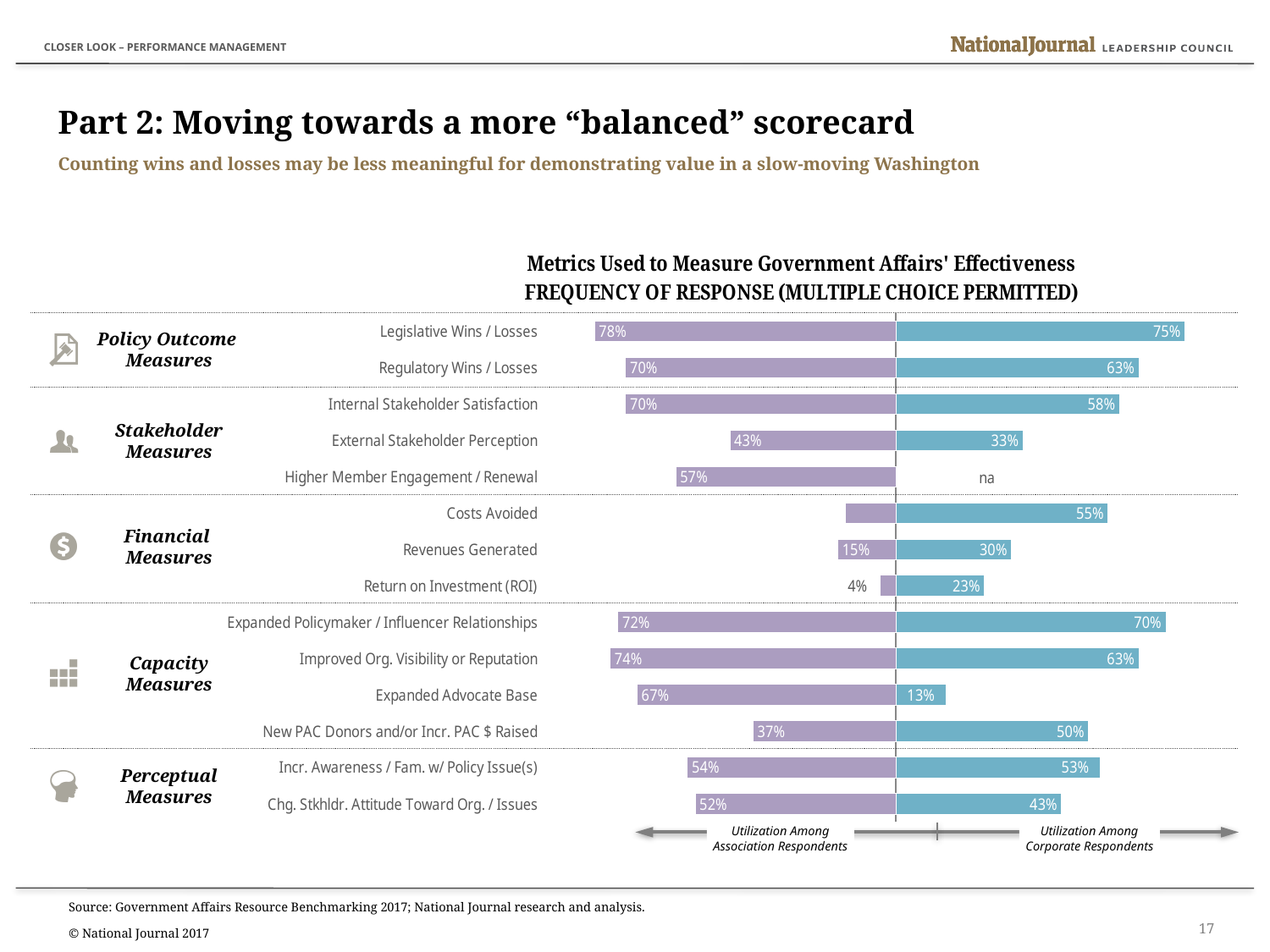
Which metric has the highest utilization among association respondents? Legislative Wins / Losses How many metrics are listed in the chart? 14 What type of chart is used to show the metrics? Bar chart What is the difference between association and corporate respondents for Expanded Advocate Base? 54 percentage points What is the title of the chart? Metrics Used to Measure Government Affairs' Effectiveness Which metric has the highest utilization among corporate respondents? Legislative Wins / Losses Which metric has the lowest labeled utilization among association respondents? Return on Investment (ROI) What percentage of association respondents use Legislative Wins / Losses as a metric? 78% For New PAC Donors and/or Incr. PAC $ Raised, which group has the higher utilization: association or corporate respondents? Corporate respondents What is shown for Higher Member Engagement / Renewal among corporate respondents? na What is the value for Return on Investment (ROI) among corporate respondents? 23% What percentage of corporate respondents use Expanded Advocate Base as a metric? 13%